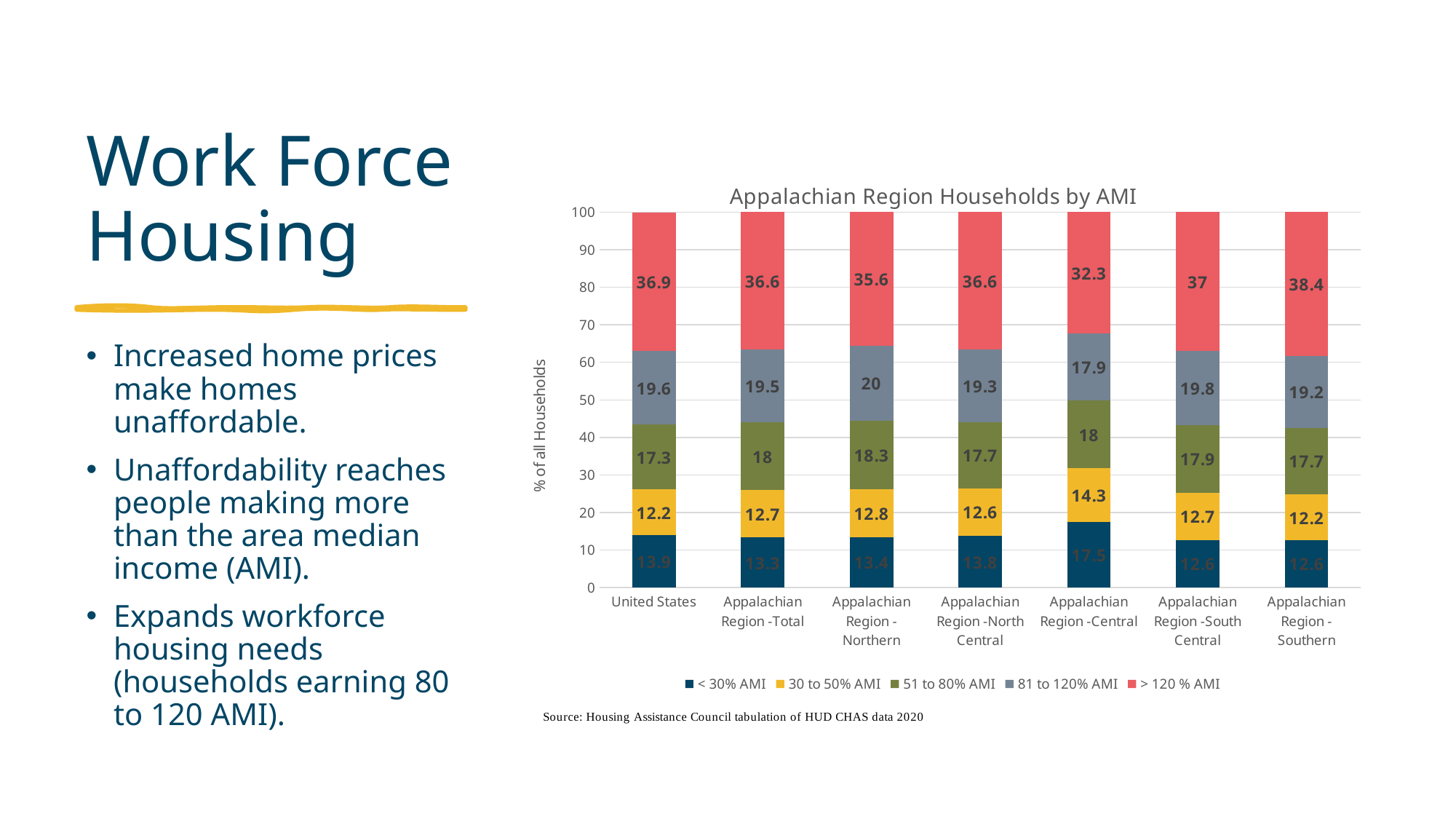
What is the title of the chart? Appalachian Region Households by AMI What is the difference between the > 120 % AMI values for Appalachian Region - Southern and Appalachian Region -Central? 6.1 How many series does the legend list? 5 Which is larger, the 51 to 80% AMI value for Appalachian Region - Northern or for the United States? Appalachian Region - Northern What is the value for 81 to 120% AMI in the United States? 19.6 How many categories are shown on the x axis? 7 Which category has the highest value for > 120 % AMI? Appalachian Region - Southern What is the value for < 30% AMI in Appalachian Region -Central? 17.5 What type of chart is shown on the slide? Stacked bar chart Which category has the lowest value for > 120 % AMI? Appalachian Region -Central Which category has the highest value for 30 to 50% AMI? Appalachian Region -Central What is the value for > 120 % AMI in Appalachian Region - Southern? 38.4